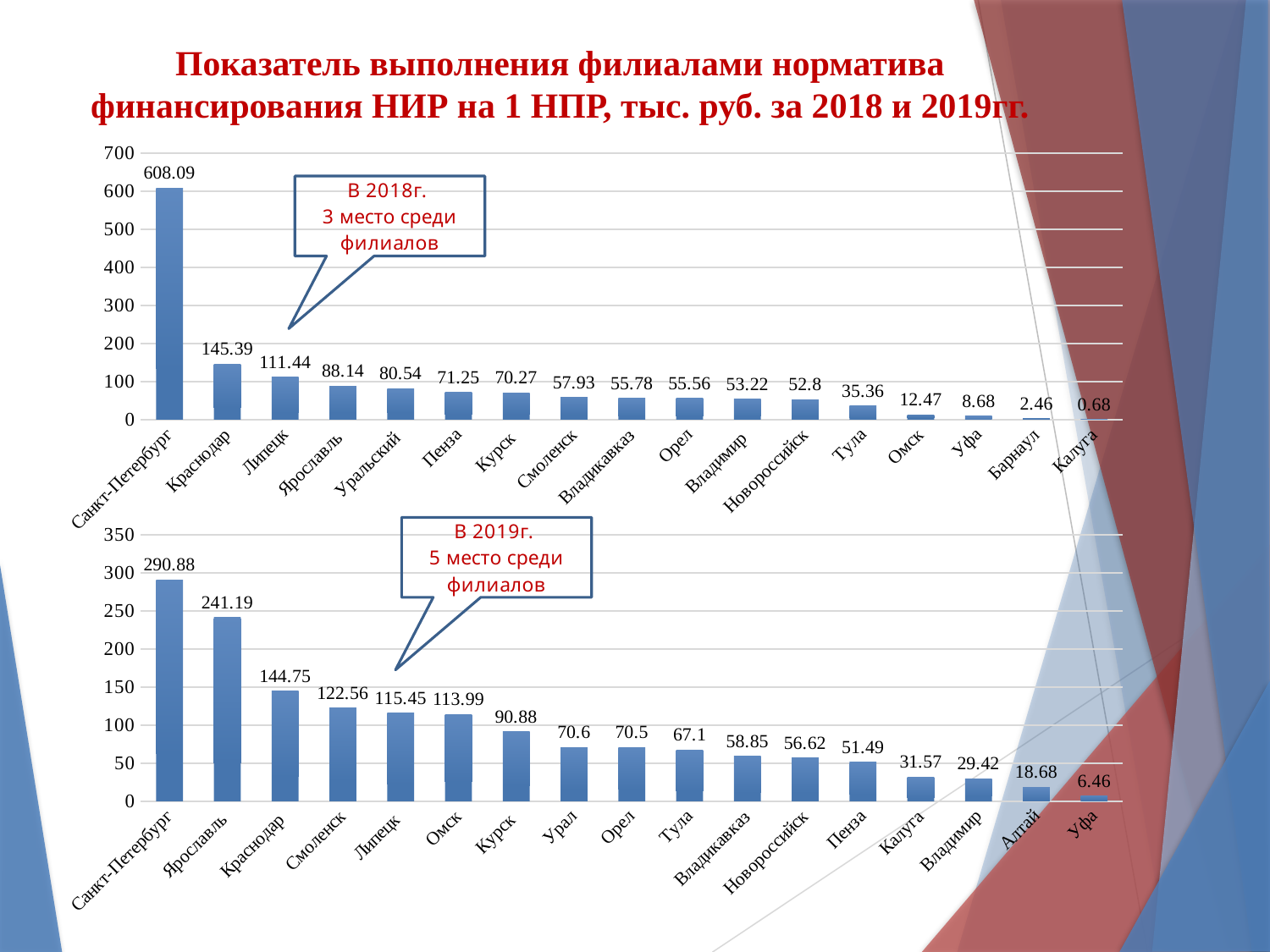
In the bottom chart (2019), which is larger, the value for Смоленск or the value for Курск? Смоленск In the bottom chart (2019), which branch has the lowest value? Уфа What type of chart is used on this slide? Bar chart In the top chart (2018), what is the value for Тула? 35.36 In the bottom chart (2019), what is the value for Ярославль? 241.19 In the top chart (2018), how many branches are shown on the x axis? 17 In the top chart (2018), what is the value for Краснодар? 145.39 In the top chart (2018), which branch has the lowest value? Калуга In the bottom chart (2019), do the values rise or fall from left to right along the x axis? Fall In the bottom chart (2019), what is the value for Калуга? 31.57 In the bottom chart (2019), what is the difference between Санкт-Петербург and Ярославль? 49.69 In the top chart (2018), which branch has the highest value? Санкт-Петербург